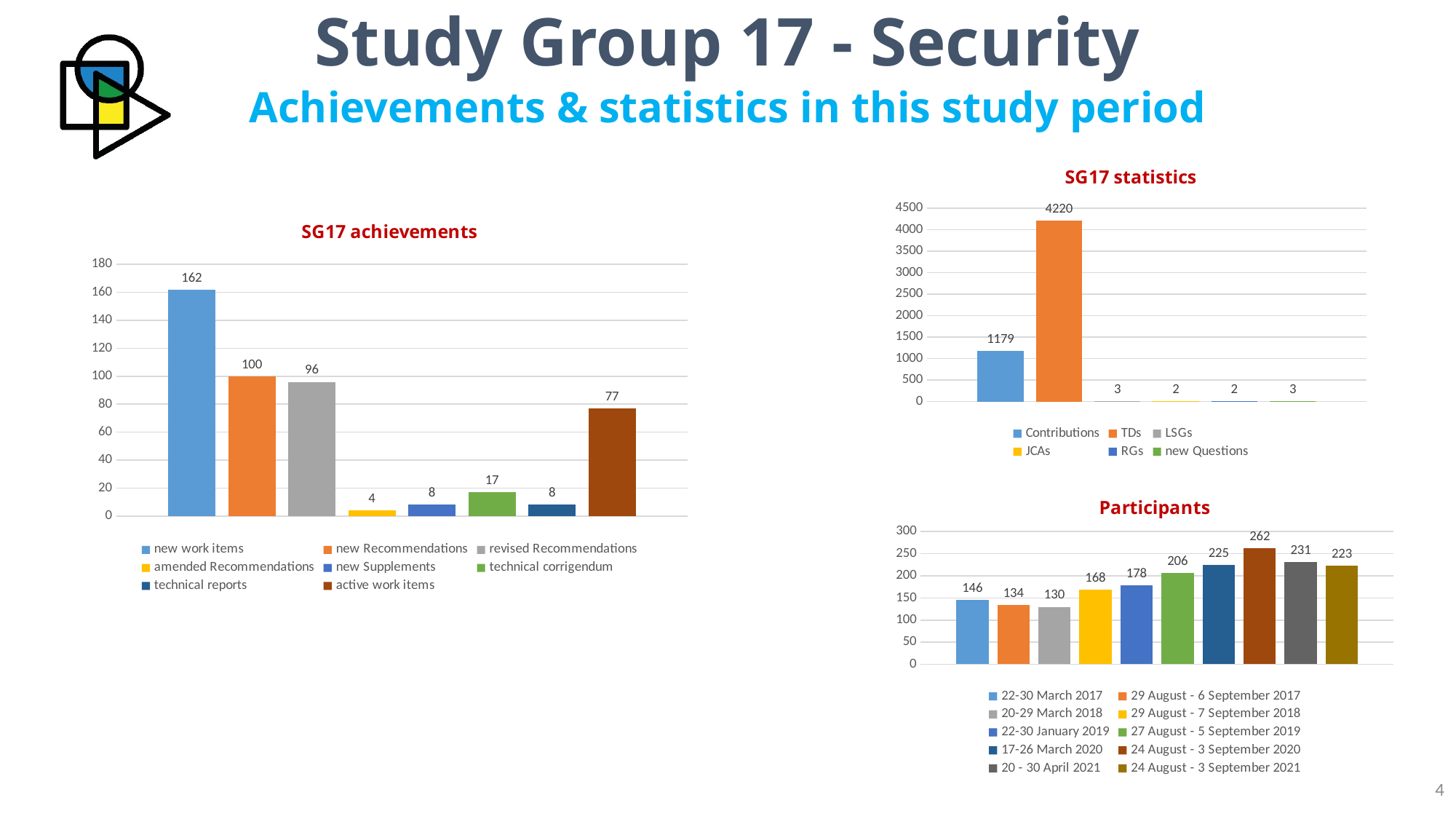
In the Participants chart, what is the value for 24 August - 3 September 2020? 262 In the Participants chart, which meeting has the lowest number of participants? 20-29 March 2018 In the SG17 statistics chart, how many series does the legend list? 6 In the SG17 statistics chart, what is the difference between TDs and Contributions? 3041 In the SG17 statistics chart, which category has the highest value? TDs In the SG17 achievements chart, what is the value for new work items? 162 What kind of chart is the Participants chart? bar chart In the SG17 achievements chart, how many categories are plotted? 8 In the SG17 achievements chart, what is the difference between new Recommendations and revised Recommendations? 4 In the Participants chart, which is larger: 22-30 March 2017 or 29 August - 7 September 2018? 29 August - 7 September 2018 In the SG17 achievements chart, which category has the lowest value? amended Recommendations In the SG17 statistics chart, what is the value for TDs? 4220